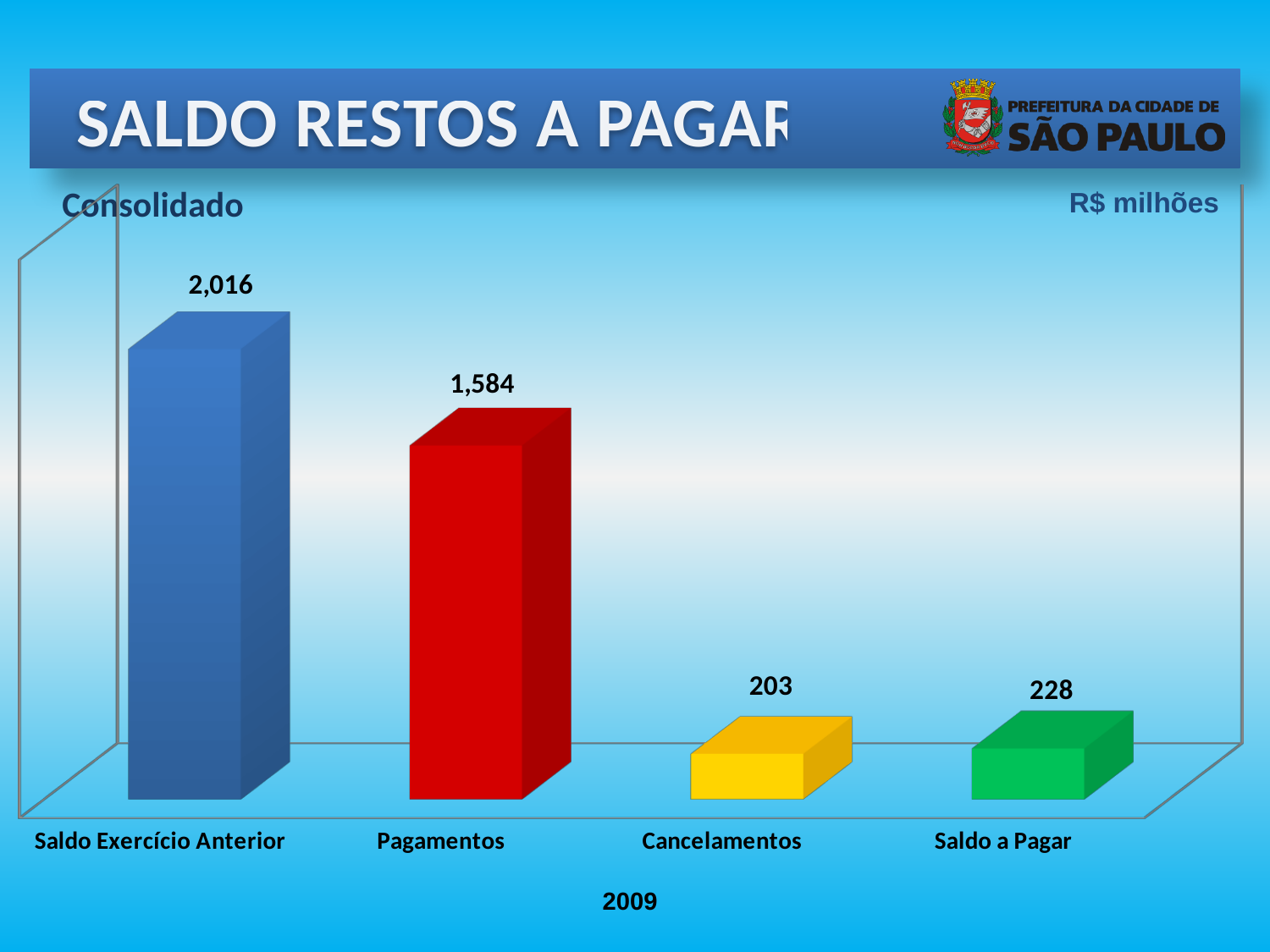
Which category has the highest value? Saldo Exercício Anterior What kind of chart is shown on the slide? Bar chart What is the difference between Saldo Exercício Anterior and Pagamentos? 432 What is the value for Saldo Exercício Anterior? 2,016 Which category has the lowest value? Cancelamentos Which is larger, Pagamentos or Saldo a Pagar? Pagamentos What is the value for Pagamentos? 1,584 What unit is indicated for the values in the chart? R$ milhões How many categories are shown in the chart? 4 What is the difference between Saldo a Pagar and Cancelamentos? 25 What is the value for Saldo a Pagar? 228 What is the value for Cancelamentos? 203